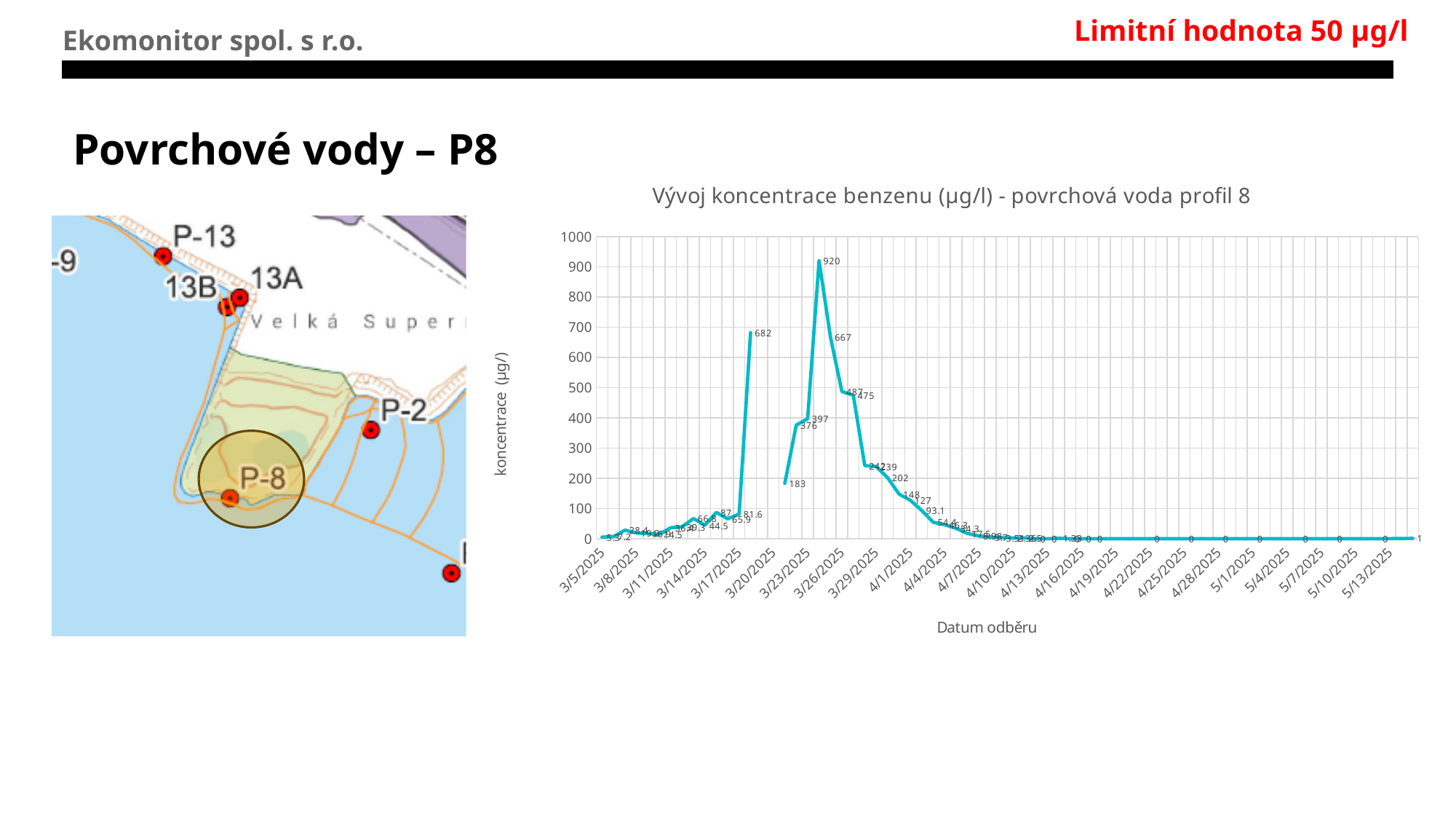
What is the difference between the peak value of 920 and the labelled value of 682? 238 What is the lowest value labelled on the chart? 0 What is the difference between the labelled values 667 and 487? 180 What is the label of the x axis of the chart? Datum odběru Is the peak value of the line greater or less than 900? greater Do the values rise or fall along the x axis after the peak of 920? fall What kind of chart is shown on the slide? line chart What is the title of the chart? Vývoj koncentrace benzenu (µg/l) - povrchová voda profil 8 How many date labels are shown on the x axis? 24 What is the highest tick value shown on the y axis? 1000 What is the highest benzene concentration value labelled on the chart? 920 Which labelled value is larger, 682 or 667? 682